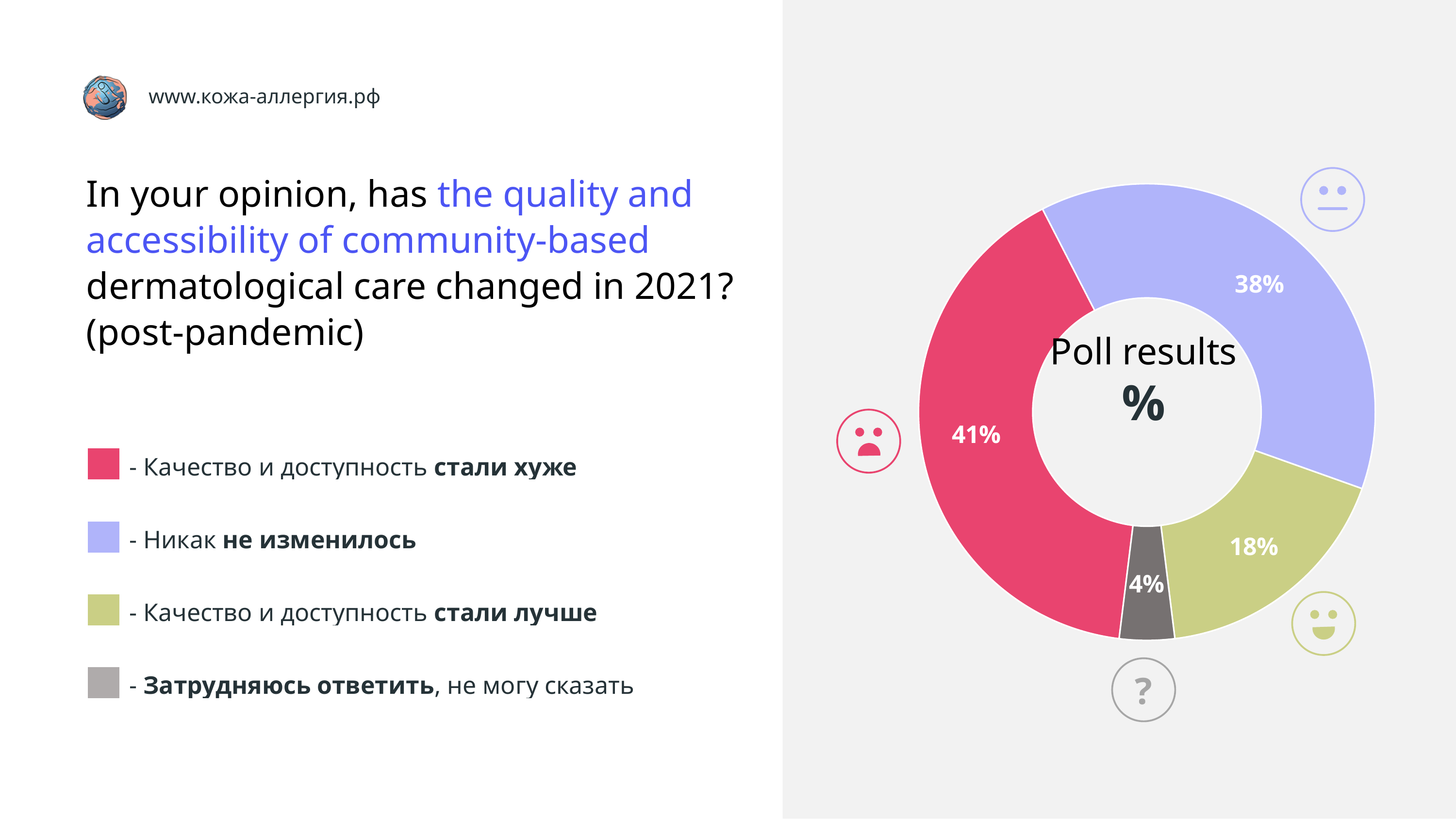
What percentage of respondents said quality and accessibility became worse (стали хуже)? 41% Which is larger: the share for 'стали лучше' or the share for 'Затрудняюсь ответить'? стали лучше What kind of chart is used to show the poll results? Pie chart (donut) Which response option has the largest share of the poll results? Качество и доступность стали хуже What percentage of respondents found it difficult to answer (Затрудняюсь ответить)? 4% What percentage of respondents said quality and accessibility became better (стали лучше)? 18% What is the difference in percentage points between 'стали хуже' and 'не изменилось'? 3 What percentage of respondents said nothing changed (не изменилось)? 38% What colour represents the 'не изменилось' category in the chart? Light purple Which response option has the smallest share of the poll results? Затрудняюсь ответить What is the difference in percentage points between 'стали лучше' and 'Затрудняюсь ответить'? 14 How many response categories are shown in the chart? 4